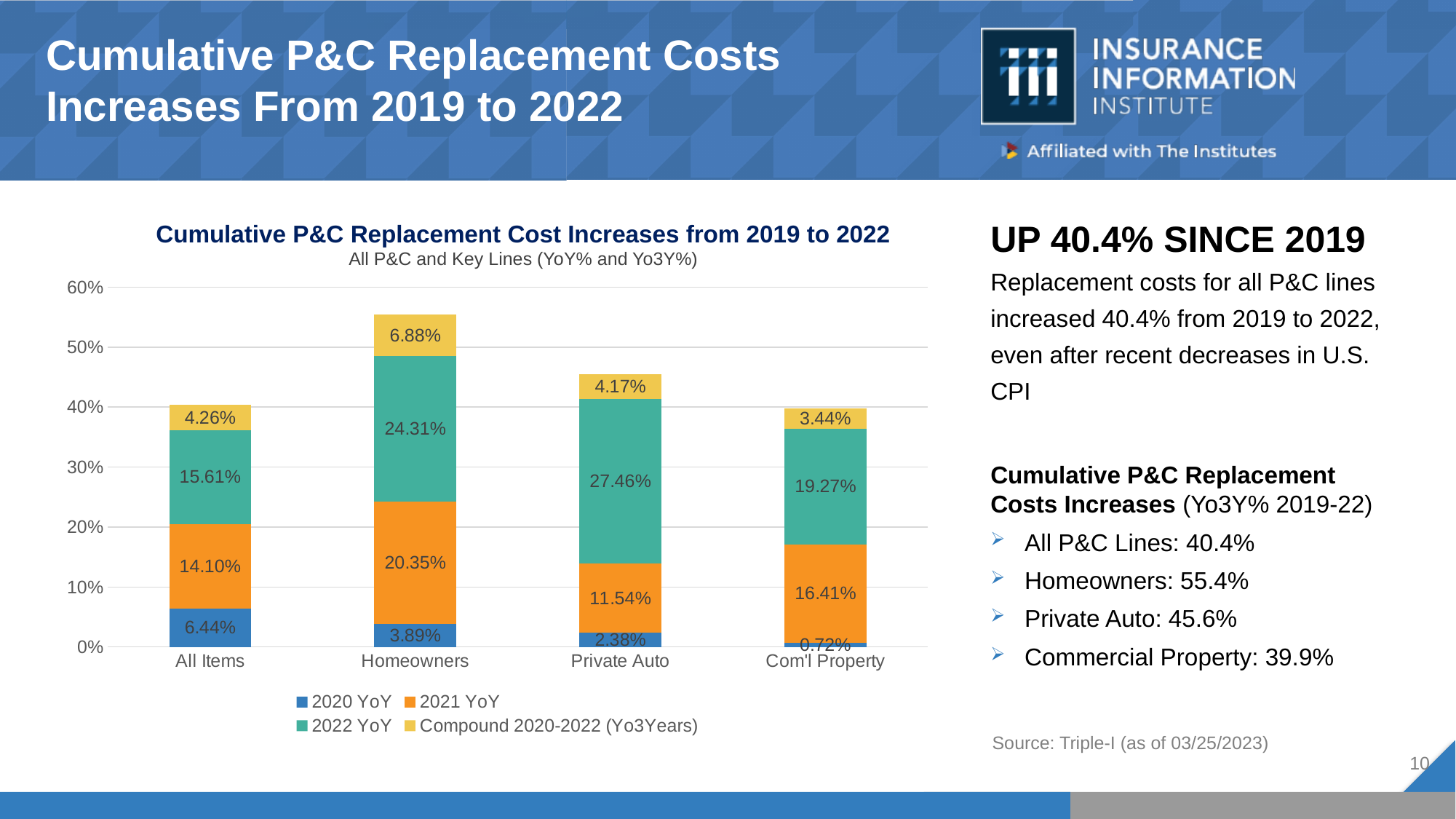
How many series does the legend list? 4 What is the 2020 YoY value for Com'l Property? 0.72% Which category has the tallest stacked bar overall? Homeowners Which is larger: the 2021 YoY value for Com'l Property or for Private Auto? Com'l Property What is the Compound 2020-2022 (Yo3Years) value for All Items? 4.26% How many categories are shown on the x axis? 4 Is the total stacked value for Homeowners greater or less than 50%? greater Which category has the lowest 2020 YoY value? Com'l Property What is the difference between the 2022 YoY values for Private Auto and Homeowners? 3.15 percentage points What is the 2022 YoY value for Private Auto? 27.46% Which category has the highest 2022 YoY value? Private Auto What is the 2021 YoY value for Homeowners? 20.35%